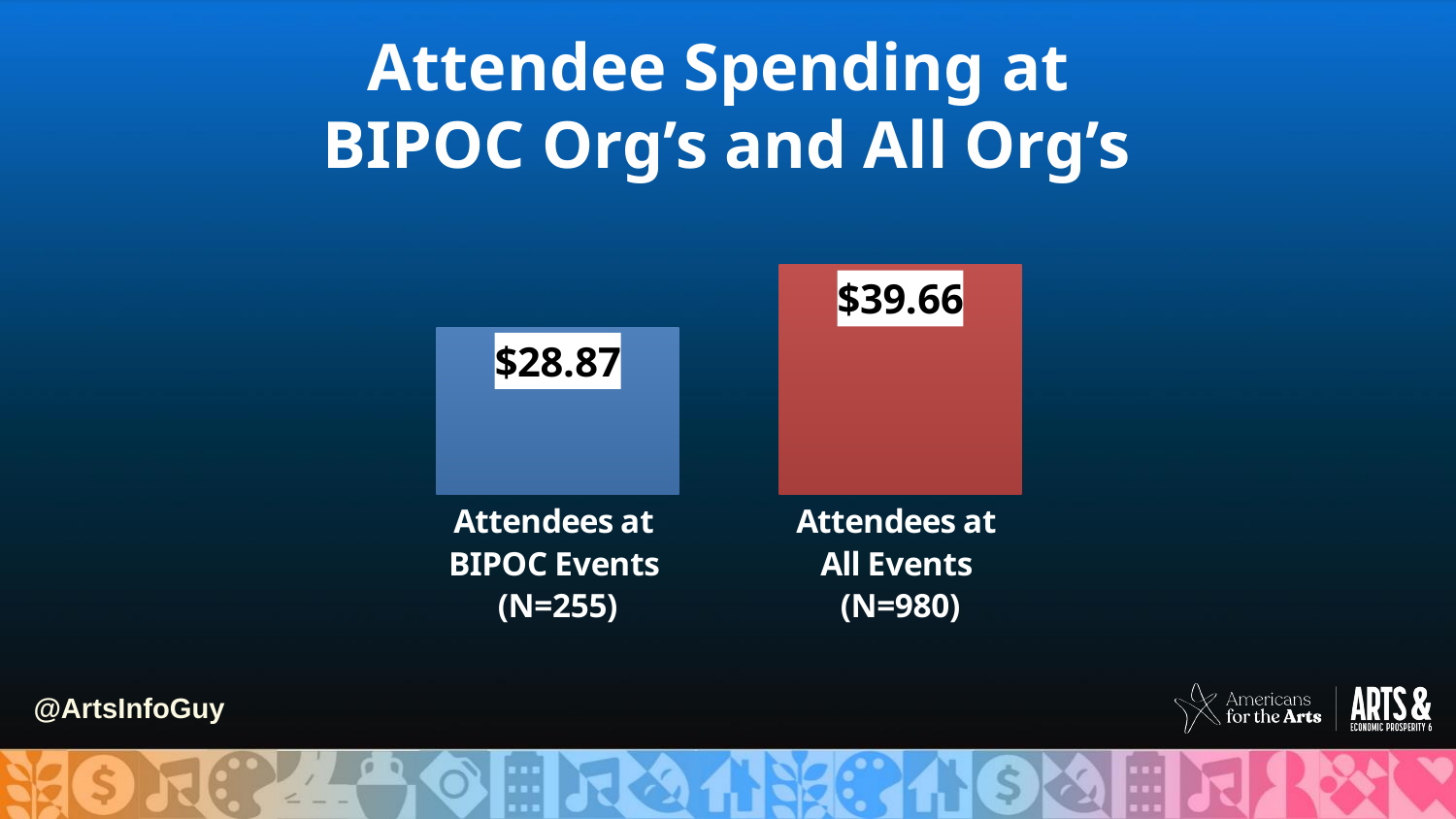
What is the sample size (N) for Attendees at BIPOC Events? 255 What kind of chart is shown on the slide? bar chart What is the attendee spending value for Attendees at BIPOC Events? $28.87 Which category has the lowest attendee spending? Attendees at BIPOC Events How many categories are shown in the chart? 2 What is the sample size (N) for Attendees at All Events? 980 What colour is the bar for Attendees at All Events? red What is the title of the chart? Attendee Spending at BIPOC Org's and All Org's Which category has the highest attendee spending? Attendees at All Events What is the attendee spending value for Attendees at All Events? $39.66 Is the spending for Attendees at BIPOC Events larger or smaller than for Attendees at All Events? smaller What is the difference in spending between Attendees at All Events and Attendees at BIPOC Events? $10.79